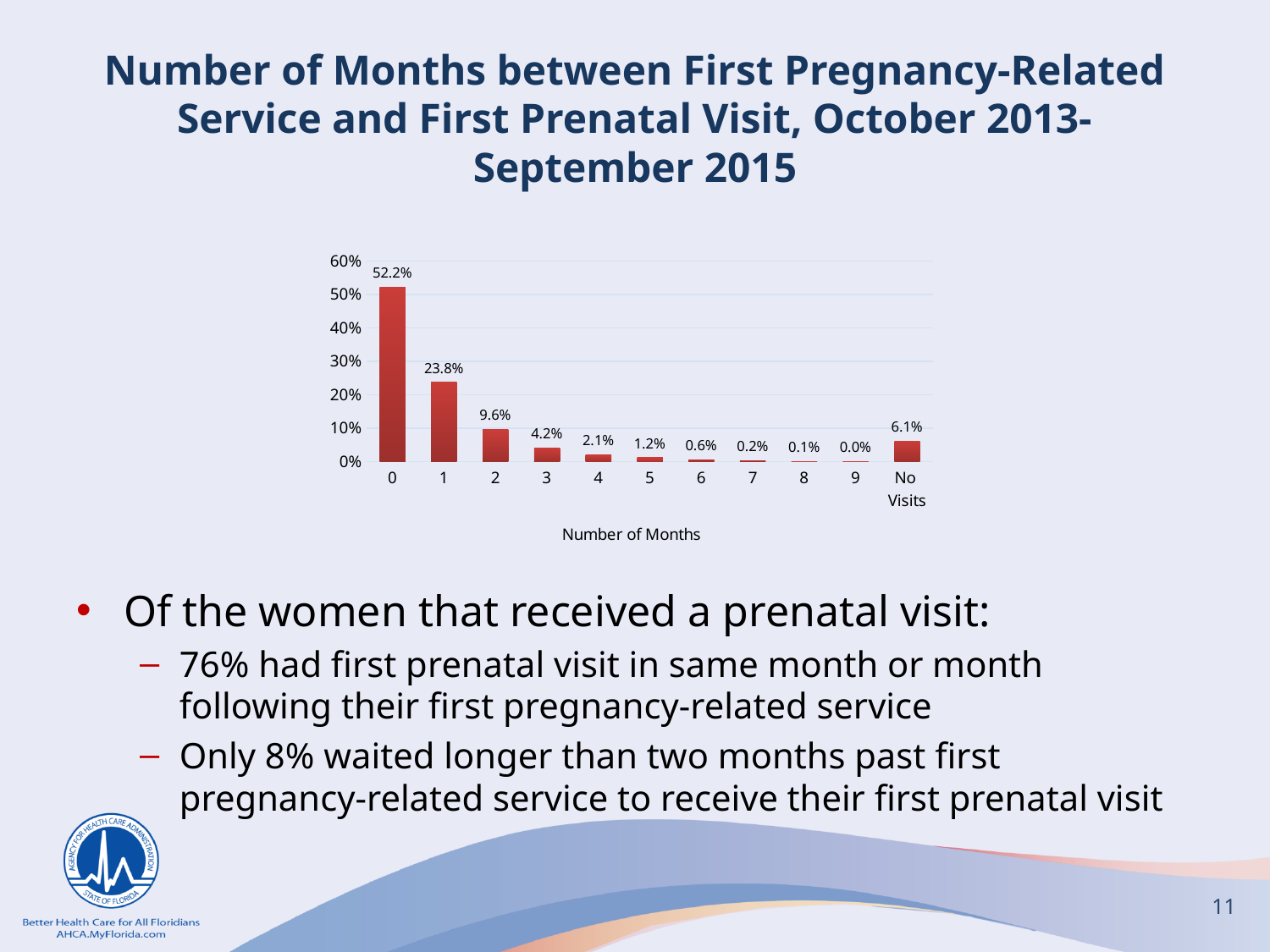
How many categories are shown on the x axis? 11 Which is larger, the percentage for 2 months or the percentage for 'No Visits'? 2 months What percentage is shown for the 'No Visits' category? 6.1% What kind of chart is shown on the slide? Bar chart What percentage is shown for 3 months? 4.2% What percentage is shown for 1 month? 23.8% Which category has the lowest percentage? 9 What percentage is shown for 0 months between first pregnancy-related service and first prenatal visit? 52.2% What is the difference in percentage points between the 0 months and 1 month categories? 28.4 Which category has the highest percentage? 0 What is the x-axis title of the chart? Number of Months Is the value for 0 months greater or less than 50%? greater